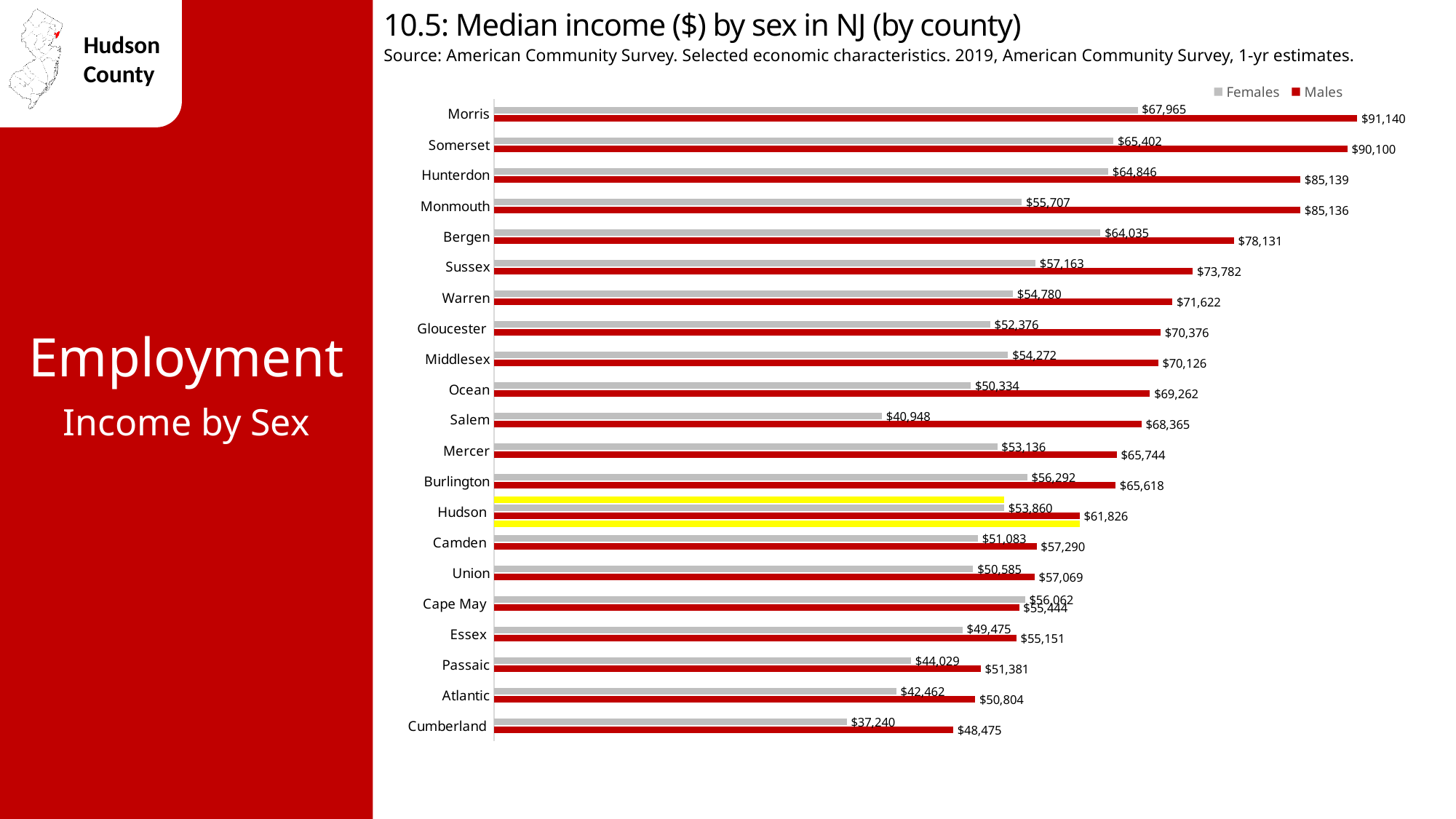
Which county has the lowest median income for females? Cumberland What is the difference between male and female median income in Hudson County? $7,966 What type of chart is shown on the slide? Bar chart What is the median income for females in Morris County? $67,965 What is the difference between the male median income in Morris County and in Somerset County? $1,040 Which county's bars are highlighted in yellow on the chart? Hudson How many series does the legend list? 2 What is the median income for females in Cumberland County? $37,240 How many counties are shown on the chart? 21 Which is larger in Cape May County, the female median income or the male median income? Female median income Which county has the highest median income for males? Morris What is the median income for males in Hudson County? $61,826